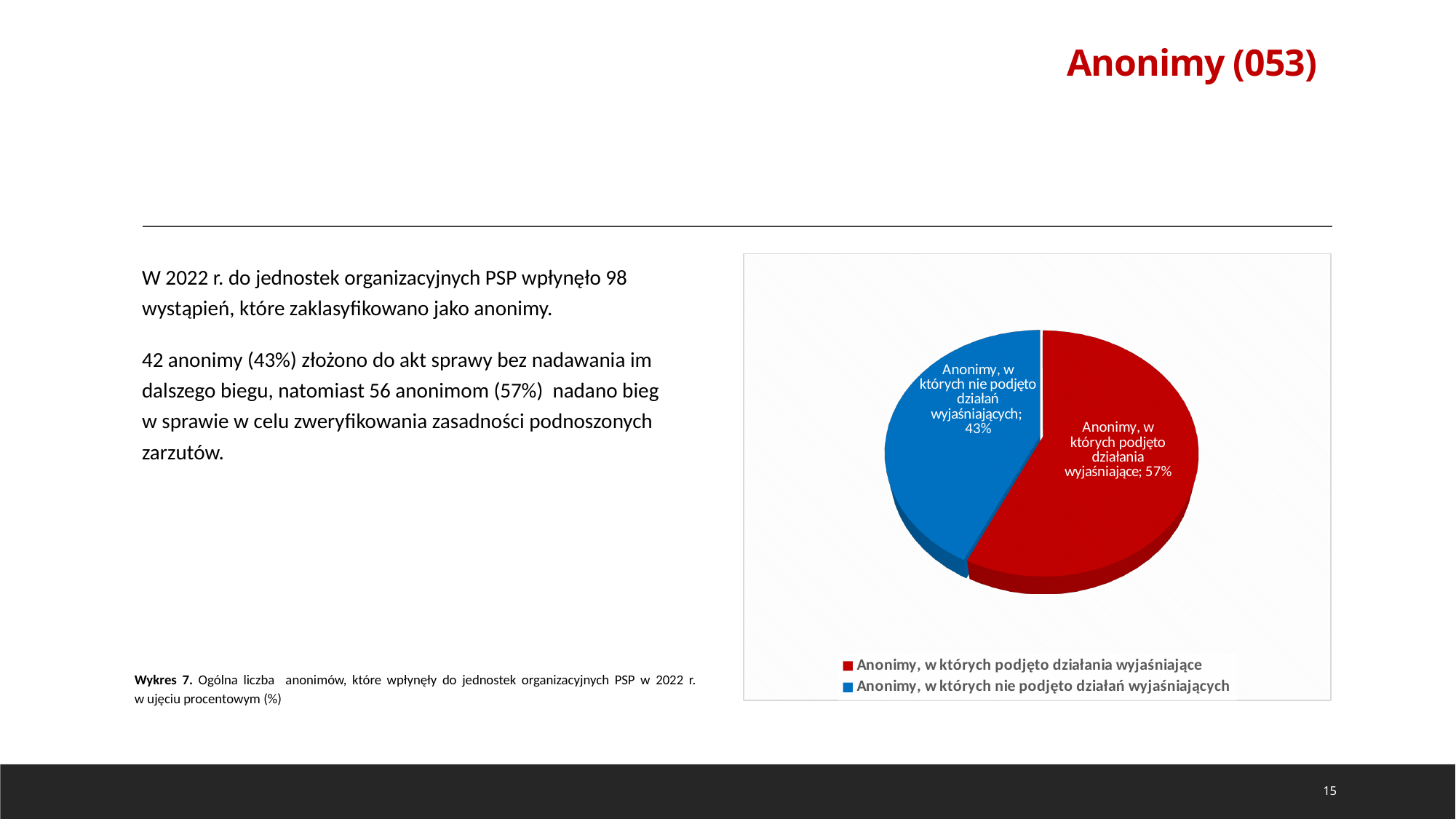
What share of the pie is labelled "Anonimy, w których nie podjęto działań wyjaśniających"? 43% Which slice of the pie is the largest? Anonimy, w których podjęto działania wyjaśniające Which slice of the pie is the smallest? Anonimy, w których nie podjęto działań wyjaśniających How many entries does the legend list? 2 What kind of chart is shown on the slide? pie chart Which is larger: the share for anonymous letters where clarifying actions were taken, or where they were not taken? Anonimy, w których podjęto działania wyjaśniające What is the difference in percentage points between the two slices of the pie? 14 What colour is the slice for "Anonimy, w których nie podjęto działań wyjaśniających"? blue What share of the pie is labelled "Anonimy, w których podjęto działania wyjaśniające"? 57% What colour is the slice for "Anonimy, w których podjęto działania wyjaśniające"? red Is the share for "Anonimy, w których podjęto działania wyjaśniające" greater or less than 50%? greater How many slices does the pie chart have? 2